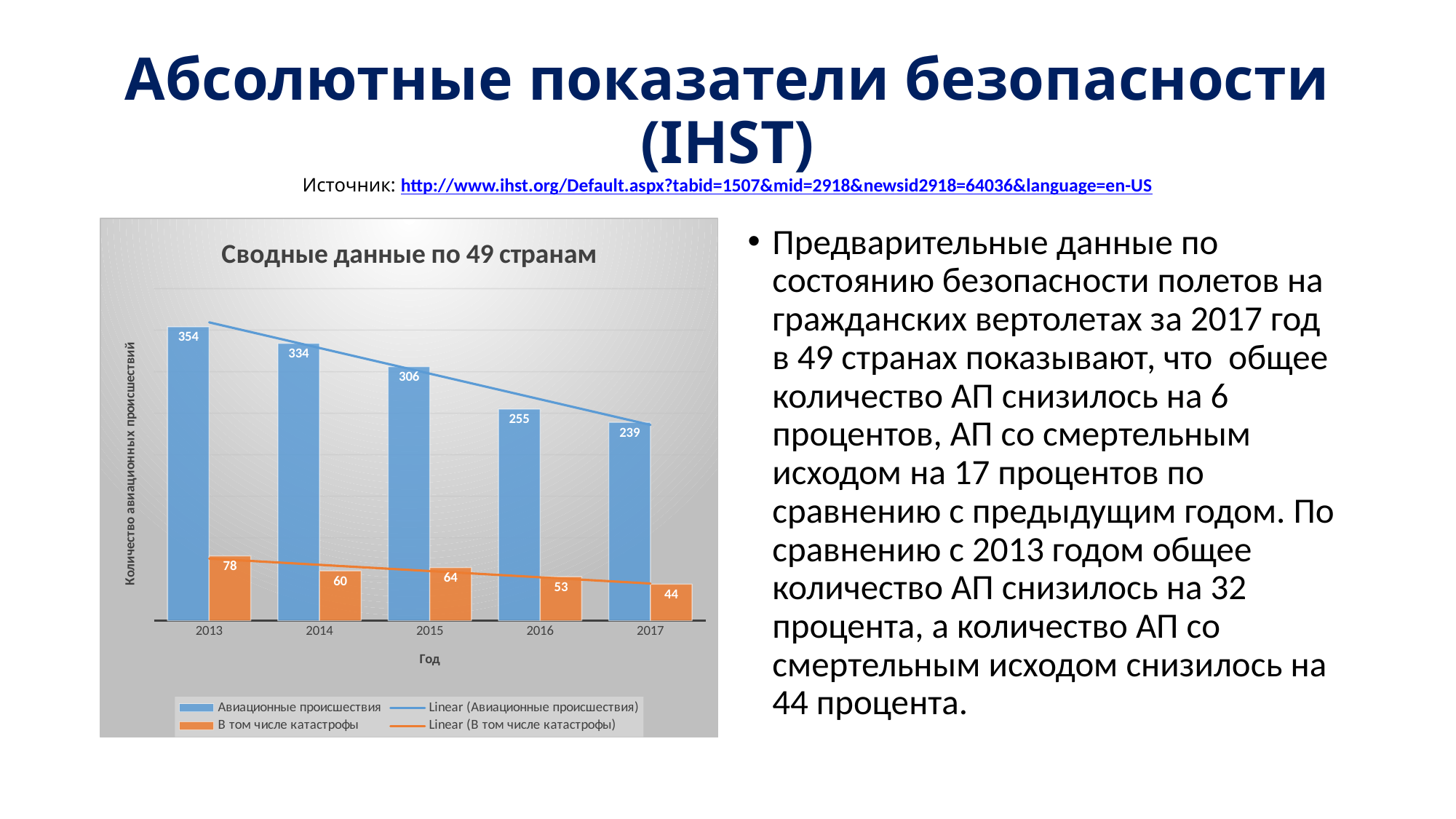
Which year has the lowest value for В том числе катастрофы? 2017 Which is larger, the В том числе катастрофы value for 2014 or for 2015? 2015 How many entries does the legend list? 4 How many years are shown on the x axis? 5 What is the value for В том числе катастрофы in 2016? 53 Which year has the highest value for Авиационные происшествия? 2013 What is the difference between the Авиационные происшествия values for 2013 and 2017? 115 Do the Авиационные происшествия values rise or fall from 2013 to 2017? Fall What kind of chart is shown on the slide? Bar chart What is the value for Авиационные происшествия in 2013? 354 What is the value for Авиационные происшествия in 2017? 239 What is the title of the chart? Сводные данные по 49 странам